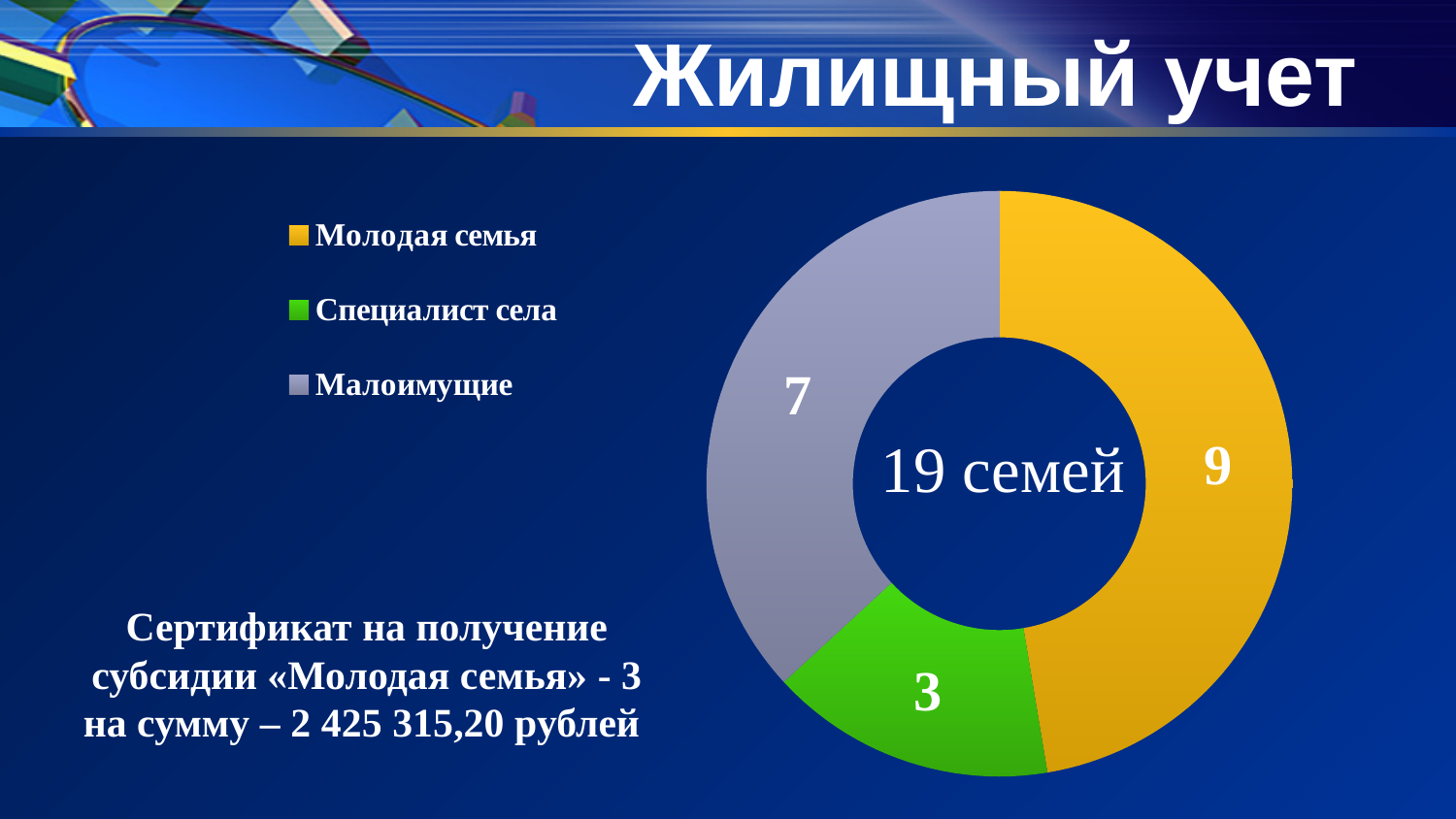
What colour represents Специалист села in the chart? green What kind of chart is shown on the slide? doughnut (pie) chart Which category has the smallest value? Специалист села What is the value for Молодая семья? 9 What is the value for Малоимущие? 7 What is the difference between the values for Молодая семья and Малоимущие? 2 Which is larger, the value for Малоимущие or the value for Специалист села? Малоимущие What is the value for Специалист села? 3 What is the difference between the values for Малоимущие and Специалист села? 4 How many categories does the chart show? 3 Which category has the largest value? Молодая семья What is the total of all the values in the chart? 19